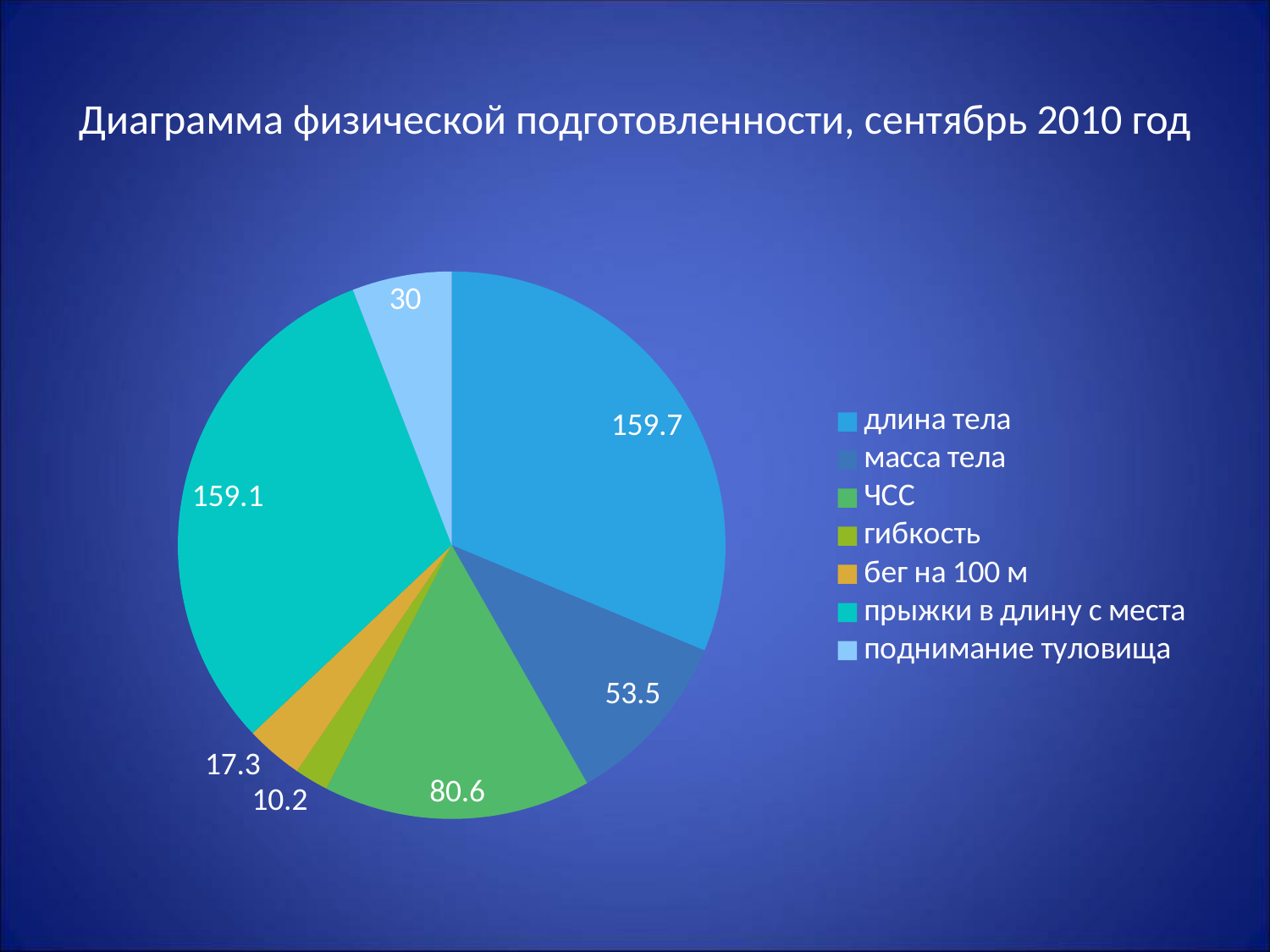
How many categories does the pie chart show? 7 What is the value for прыжки в длину с места? 159.1 What is the difference between the values for длина тела and масса тела? 106.2 Which category has the largest slice? длина тела What is the value for поднимание туловища? 30 Which category has the smallest slice? гибкость What is the value for ЧСС? 80.6 What kind of chart is shown on the slide? pie chart What is the value for длина тела? 159.7 What is the value for масса тела? 53.5 What is the title of the chart? Диаграмма физической подготовленности, сентябрь 2010 год Which is larger, the value for ЧСС or the value for поднимание туловища? ЧСС